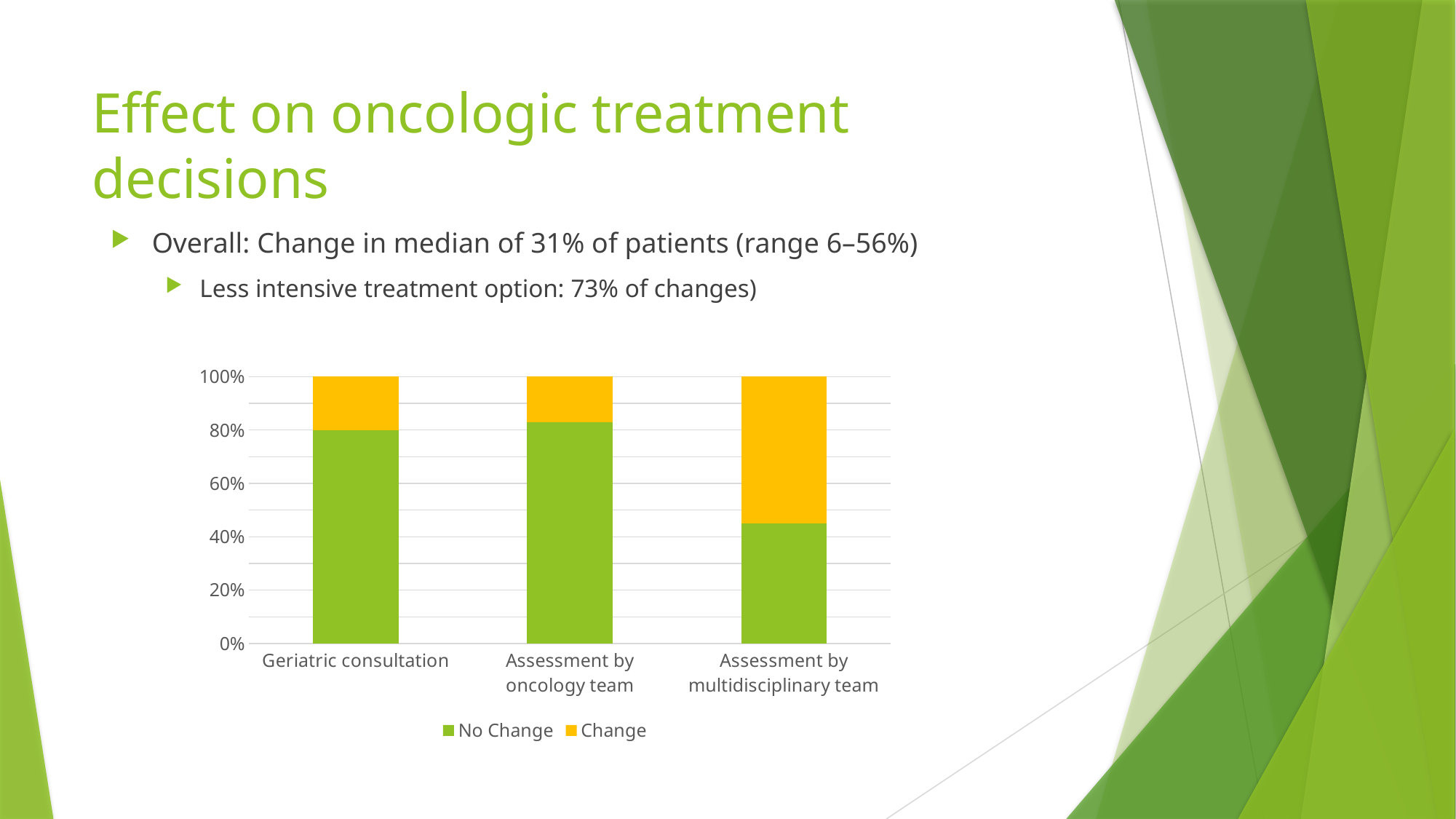
What is the total height of each stacked bar in the chart? 100% How many categories are shown on the x axis of the chart? 3 How many series does the chart legend list? 2 Is the 'Change' share for Assessment by multidisciplinary team greater or less than 40%? greater Which category has the largest 'Change' share? Assessment by multidisciplinary team Which has the larger 'No Change' share: Assessment by oncology team or Assessment by multidisciplinary team? Assessment by oncology team What are the two series listed in the chart legend? No Change and Change Which has the larger 'Change' share: Geriatric consultation or Assessment by multidisciplinary team? Assessment by multidisciplinary team Which category has the smallest 'No Change' share? Assessment by multidisciplinary team Is the 'No Change' value for Assessment by multidisciplinary team greater or less than 60%? less What kind of chart is shown on the slide? Stacked bar chart Is the 'No Change' value for Geriatric consultation greater or less than 60%? greater